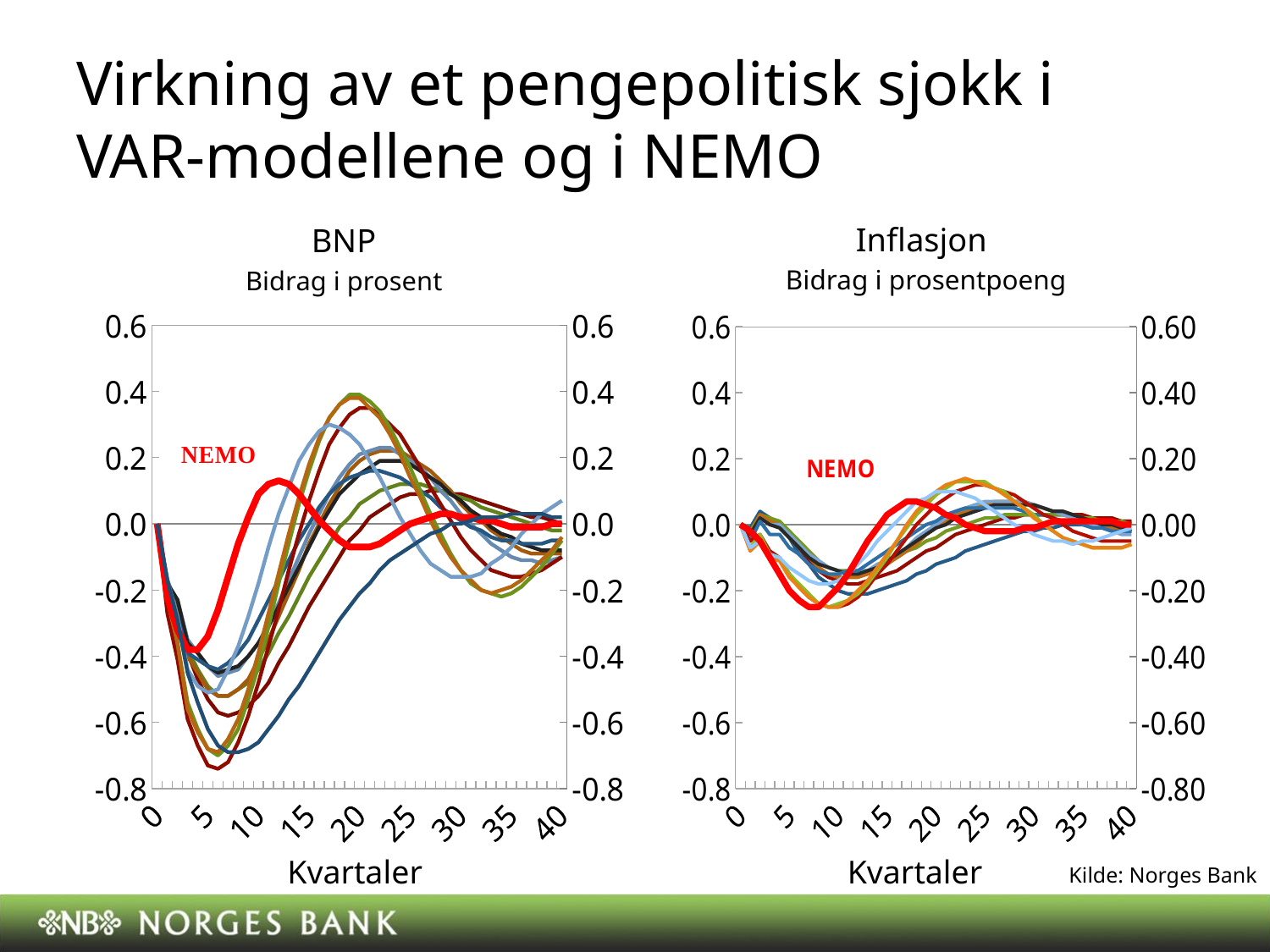
In the BNP chart, is the value of the NEMO line at quarter 5 greater or less than -0.2? less In the BNP chart, does the NEMO line rise or fall between quarter 0 and quarter 5? fall In the BNP chart, does the NEMO line rise or fall between quarter 5 and quarter 13? rise In the BNP chart, is the lowest value of the NEMO line greater or less than -0.6? greater In the BNP chart, is the highest value of the NEMO line greater or less than 0.2? less What is the subtitle under the Inflasjon chart title? Bidrag i prosentpoeng What kind of chart is the Inflasjon chart on the right? line chart In the BNP chart, what is the label on the x axis? Kvartaler In the BNP chart, is the lowest point of the NEMO line higher or lower than the lowest point of the other lines? higher What kind of chart is the BNP chart on the left? line chart